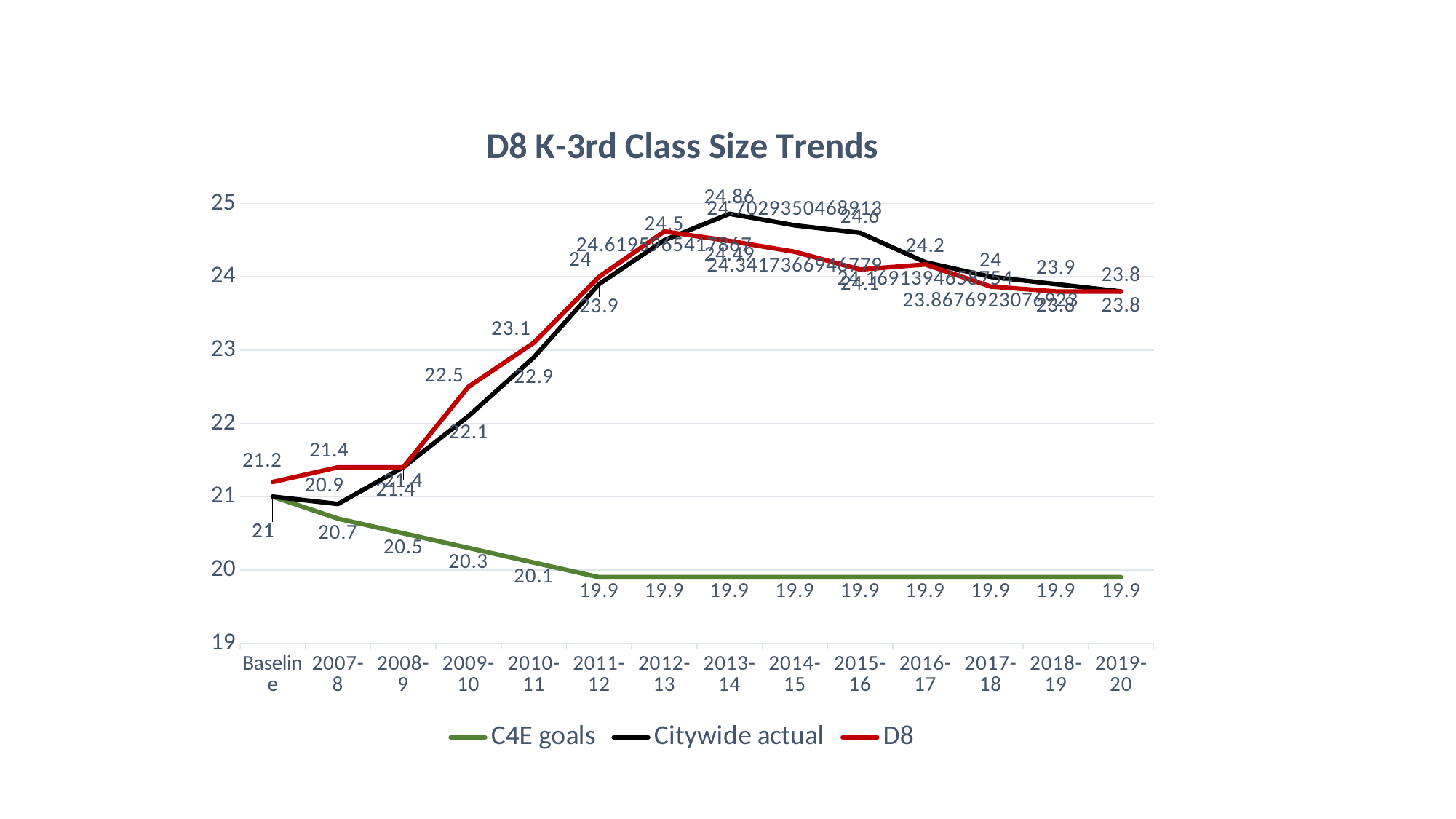
Which is larger for 2010-11, the D8 value or the Citywide actual value? D8 What is the Citywide actual value for 2013-14? 24.86 What is the C4E goals value for 2019-20? 19.9 What type of chart is shown on the slide? line chart Is the Citywide actual value for 2013-14 greater or less than 24? greater What is the difference between the D8 and Citywide actual values for 2009-10? 0.4 In which year is the Citywide actual value highest? 2013-14 What is the D8 value at Baseline? 21.2 What is the title of the chart? D8 K-3rd Class Size Trends Do the C4E goals values rise or fall from Baseline to 2019-20? fall How many series does the legend list? 3 How many categories are on the x axis? 14